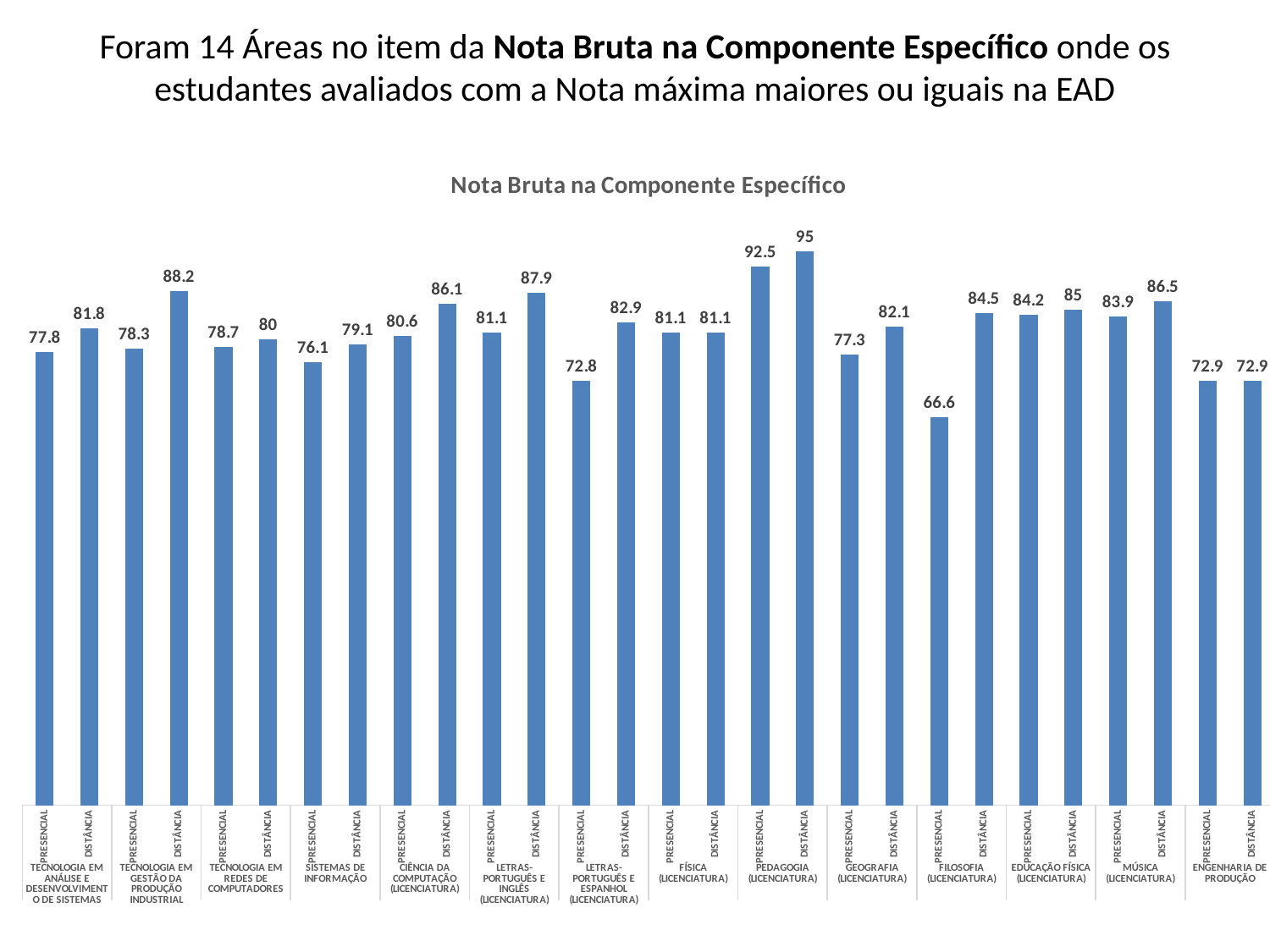
What is the value for Distância in Pedagogia (Licenciatura)? 95 What type of chart is shown on the slide? Bar chart Which bar has the lowest value in the chart? Presencial, Filosofia (Licenciatura) What is the difference between the Distância and Presencial values for Filosofia (Licenciatura)? 17.9 Which is larger: the Presencial value for Pedagogia (Licenciatura) or the Distância value for Música (Licenciatura)? Presencial value for Pedagogia (Licenciatura) What is the value for Distância in Tecnologia em Gestão da Produção Industrial? 88.2 What is the value for Presencial in Filosofia (Licenciatura)? 66.6 What is the difference between the Distância and Presencial values for Letras-Português e Espanhol (Licenciatura)? 10.1 Which bar has the highest value in the chart? Distância, Pedagogia (Licenciatura) What is the title of the chart? Nota Bruta na Componente Específico Which is larger for Ciência da Computação (Licenciatura): Presencial or Distância? Distância How many areas (course groups) are shown on the x axis of the chart? 14